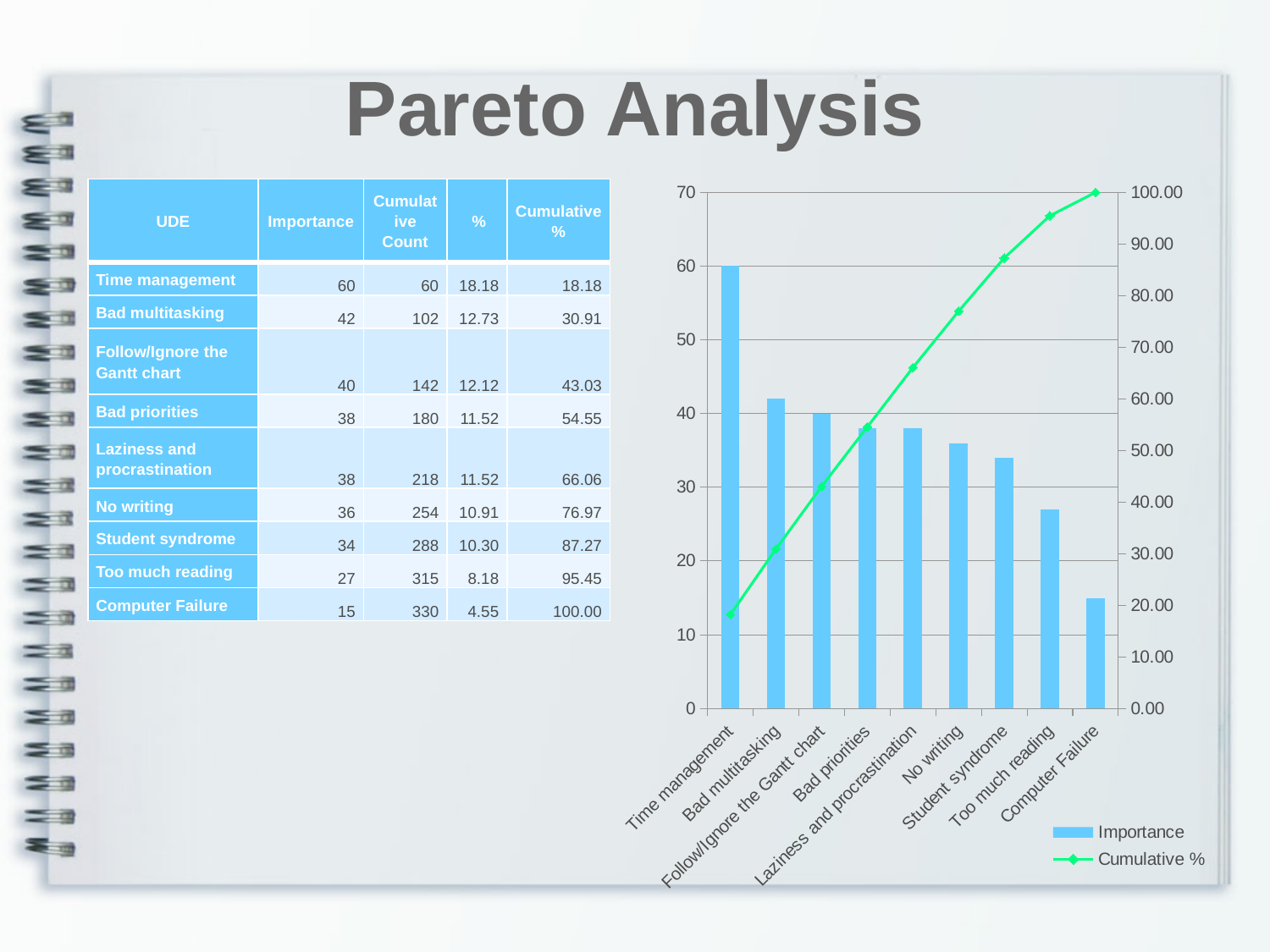
How many series does the chart legend list? 2 Which is larger, the Importance value for Bad multitasking or for Student syndrome? Bad multitasking Is the Importance value for Too much reading greater or less than 30? less Is the Importance value for Bad multitasking greater or less than 40? greater What is the Cumulative % value for Computer Failure? 100.00 What is the Importance value for Follow/Ignore the Gantt chart? 40 What kind of chart is shown on the slide? A combined bar and line chart Which category has the lowest Importance bar? Computer Failure What is the Importance value for Time management? 60 Which category has the highest Importance bar? Time management Do the Importance bars rise or fall from left to right along the x axis? Fall How many categories are plotted along the x axis of the chart? 9